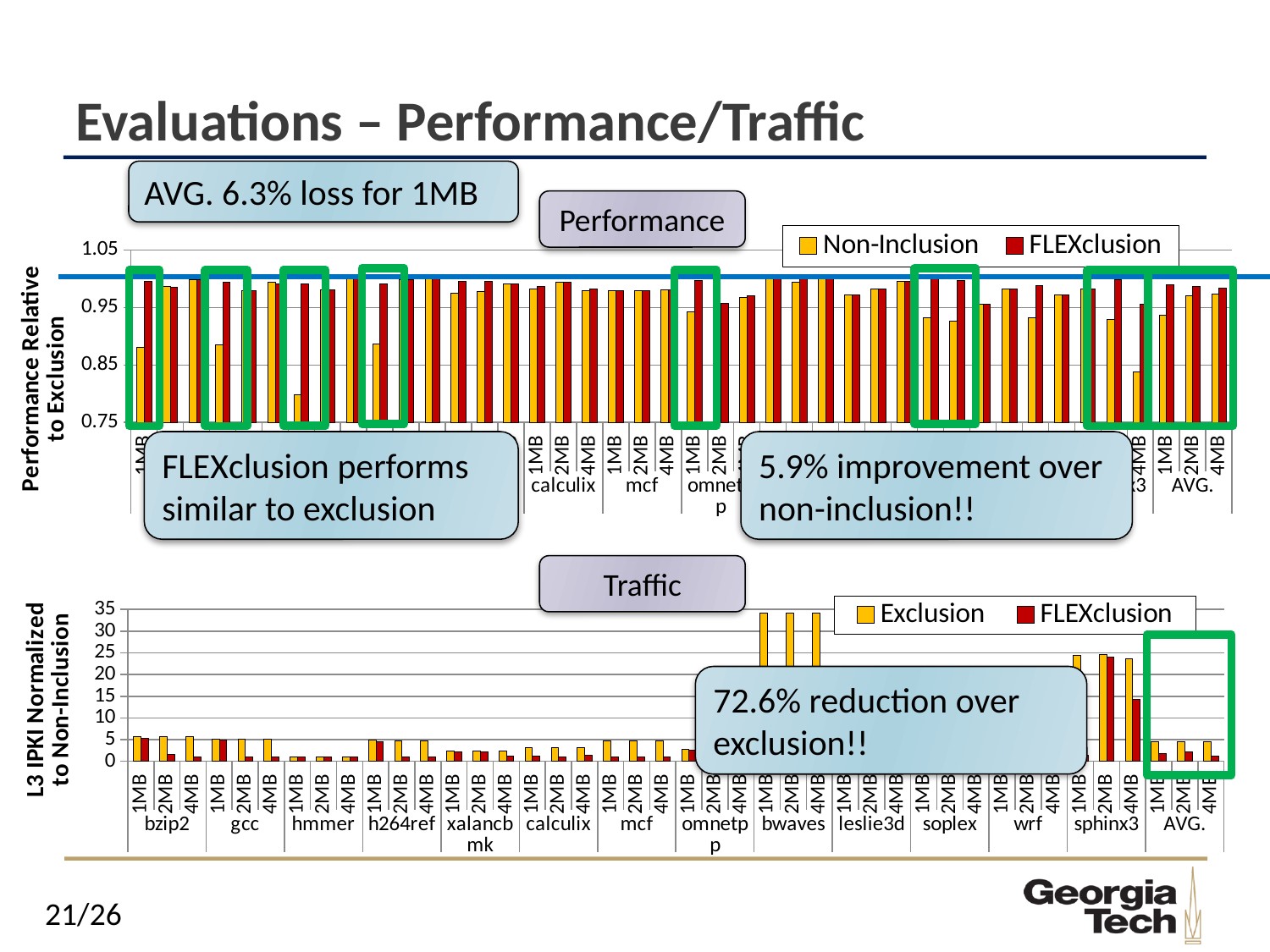
In the Traffic chart, is the Exclusion value for sphinx3 1MB greater or less than 20? greater In the Performance chart, which is larger for hmmer 1MB: Non-Inclusion or FLEXclusion? FLEXclusion How many series does the legend of the Traffic chart list? 2 In the Traffic chart, is the Exclusion value for bwaves 1MB greater or less than 30? greater In the Performance chart, is the Non-Inclusion value for hmmer 1MB greater or less than 0.85? less What kind of chart is the Performance chart at the top of the slide? bar chart What is the y-axis title of the Traffic chart? L3 IPKI Normalized to Non-Inclusion In the Traffic chart, which is larger for bwaves 1MB: Exclusion or FLEXclusion? Exclusion In the Traffic chart, how many benchmark groups (including AVG.) are shown along the x axis? 14 What are the two series named in the legend of the Performance chart? Non-Inclusion and FLEXclusion In the Traffic chart, how many cache-size bars are shown for each benchmark group per series? 3